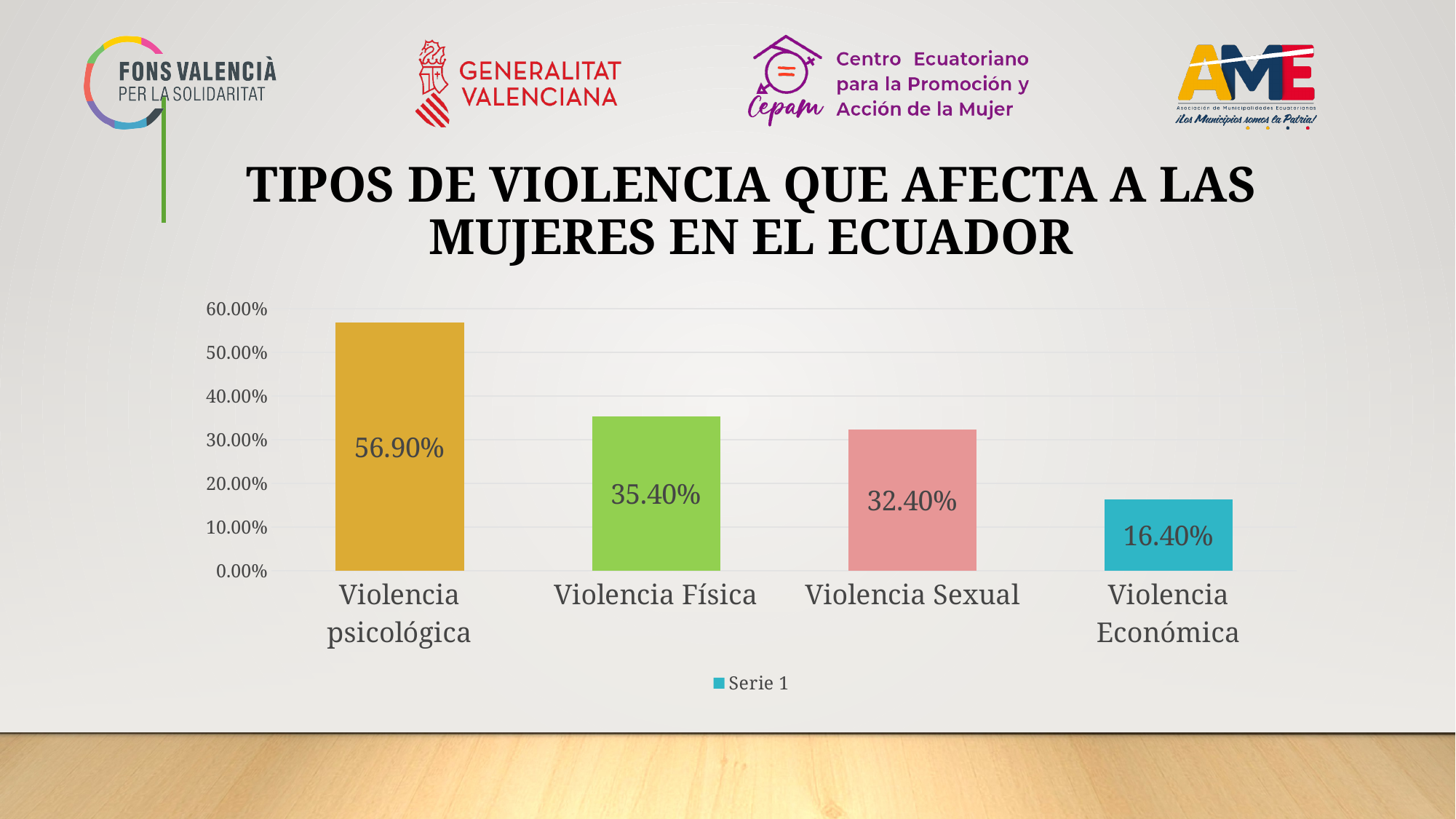
What kind of chart is shown on the slide? Bar chart What is the difference between the values for Violencia psicológica and Violencia Económica? 40.50% How many categories are shown in the chart? 4 Which is larger, the value for Violencia Física or the value for Violencia Sexual? Violencia Física What is the value for Violencia Económica? 16.40% What is the value for Violencia psicológica? 56.90% What is the value for Violencia Sexual? 32.40% What is the value for Violencia Física? 35.40% What series name does the legend show? Serie 1 Which category has the highest value? Violencia psicológica Which category has the lowest value? Violencia Económica What is the difference between the values for Violencia Física and Violencia Sexual? 3.00%